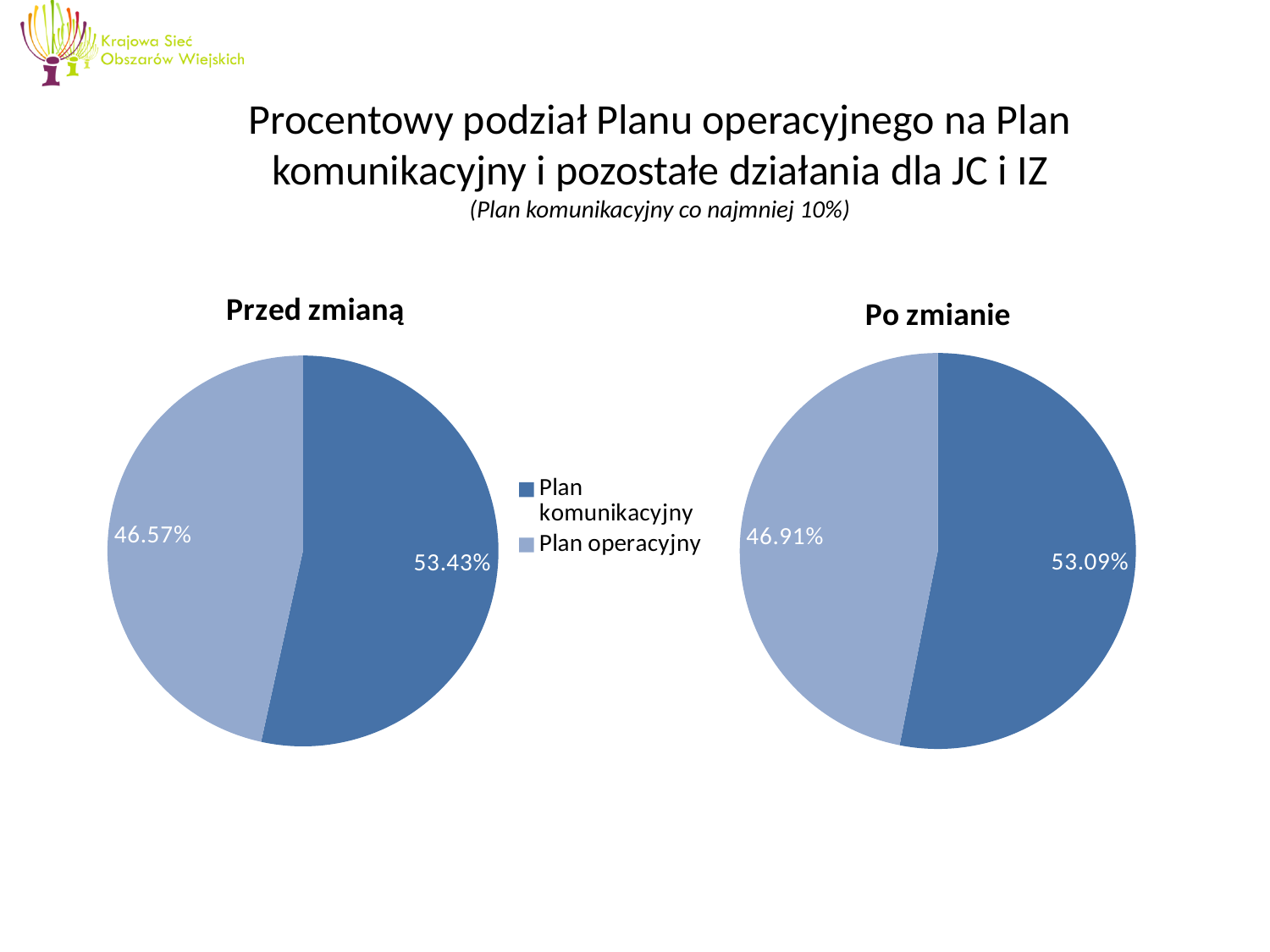
In the 'Przed zmianą' chart, which slice is the largest? Plan komunikacyjny In the 'Po zmianie' chart, which slice is the smallest? Plan operacyjny In the 'Przed zmianą' chart, what is the difference in percentage points between Plan komunikacyjny and Plan operacyjny? 6.86 In the 'Przed zmianą' chart, what share does Plan operacyjny have? 46.57% In the 'Po zmianie' chart, what is the difference in percentage points between Plan komunikacyjny and Plan operacyjny? 6.18 How many slices does the 'Przed zmianą' pie chart have? 2 In the 'Przed zmianą' chart, what share does Plan komunikacyjny have? 53.43% In the 'Po zmianie' chart, what share does Plan operacyjny have? 46.91% Is the share of Plan komunikacyjny larger in the 'Przed zmianą' chart or in the 'Po zmianie' chart? Przed zmianą How many entries does the legend list? 2 In the 'Po zmianie' chart, what share does Plan komunikacyjny have? 53.09% What type of chart is the 'Po zmianie' chart? Pie chart